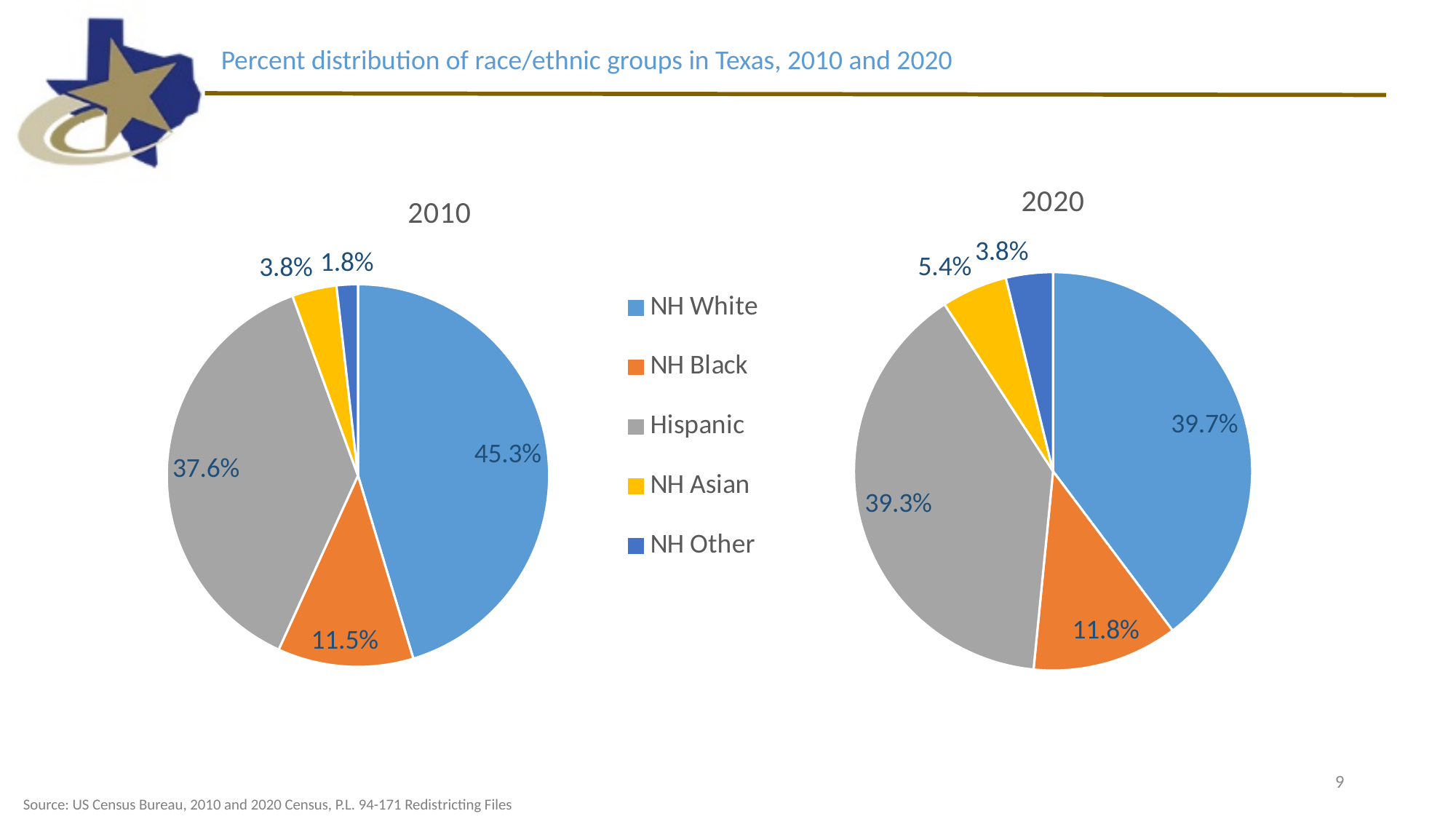
In the 2020 pie chart, what percentage is shown for Hispanic? 39.3% Is the NH Asian share larger in the 2010 pie chart or the 2020 pie chart? 2020 In the 2010 pie chart, what percentage is shown for NH White? 45.3% In the 2020 pie chart, what is the difference between the Hispanic share and the NH Black share? 27.5% In the 2010 pie chart, what percentage is shown for NH Black? 11.5% In the 2020 pie chart, which group has the smallest share? NH Other In the 2010 pie chart, which group has the largest share? NH White How many groups does the legend list? 5 What is the difference between the NH White share in 2010 and in 2020? 5.6% In the 2010 pie chart, which group has the smallest share? NH Other What type of charts are shown on the slide? Pie charts In the 2020 pie chart, what percentage is shown for NH Asian? 5.4%